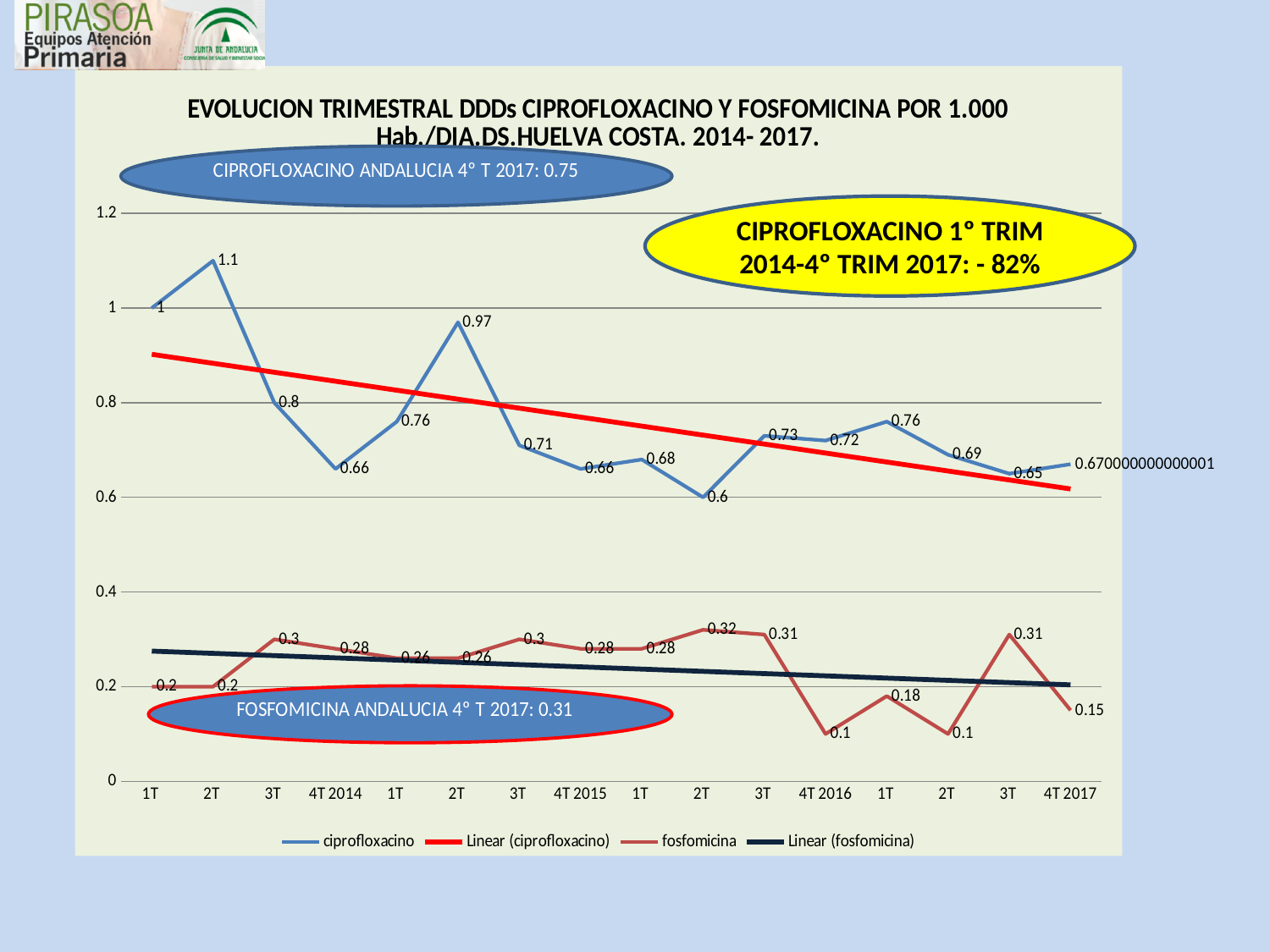
What kind of chart is shown on the slide? line chart What is the ciprofloxacino value for 2T 2014? 1.1 What is the lowest value plotted for the fosfomicina series? 0.1 Which is larger, the ciprofloxacino value for 2T 2015 or for 3T 2015? 2T 2015 What percentage change for ciprofloxacino from 1° TRIM 2014 to 4° TRIM 2017 is shown in the yellow callout? - 82% How many entries does the chart legend list? 4 What is the fosfomicina value for 4T 2017? 0.15 How many quarterly points are plotted along the x axis? 16 In which quarter does the ciprofloxacino series reach its lowest value? 2T 2016 In which quarter does the ciprofloxacino series reach its highest value? 2T 2014 Does the linear trendline for ciprofloxacino rise or fall from left to right? fall What is the difference between the ciprofloxacino values for 2T 2014 and 2T 2016? 0.5